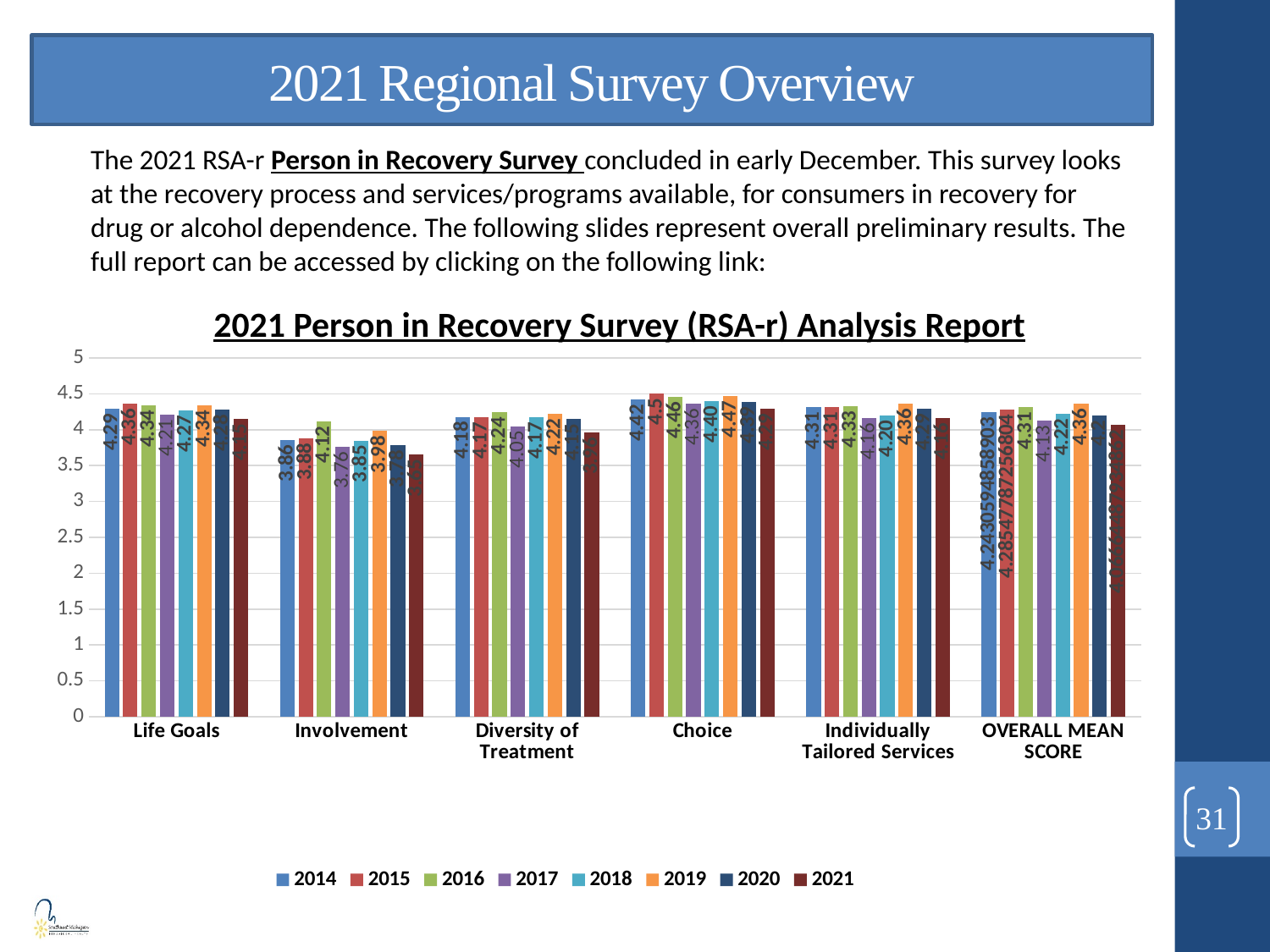
What kind of chart is shown on the slide? bar chart What is the value for 2017 in the Diversity of Treatment category? 4.05 Is the value for 2017 in the Involvement category greater or less than 4? less What is the difference between the 2016 and 2017 values in the Involvement category? 0.36 What is the value for 2019 in the Individually Tailored Services category? 4.36 Which is larger: the 2015 value for Life Goals or the 2015 value for Involvement? Life Goals How many series does the legend list? 8 Which category has the lowest values overall across the years? Involvement What is the value for 2016 in the Involvement category? 4.12 How many categories are shown along the x axis? 6 Which year has the highest value in the Involvement category? 2016 What is the value for 2015 in the Choice category? 4.5